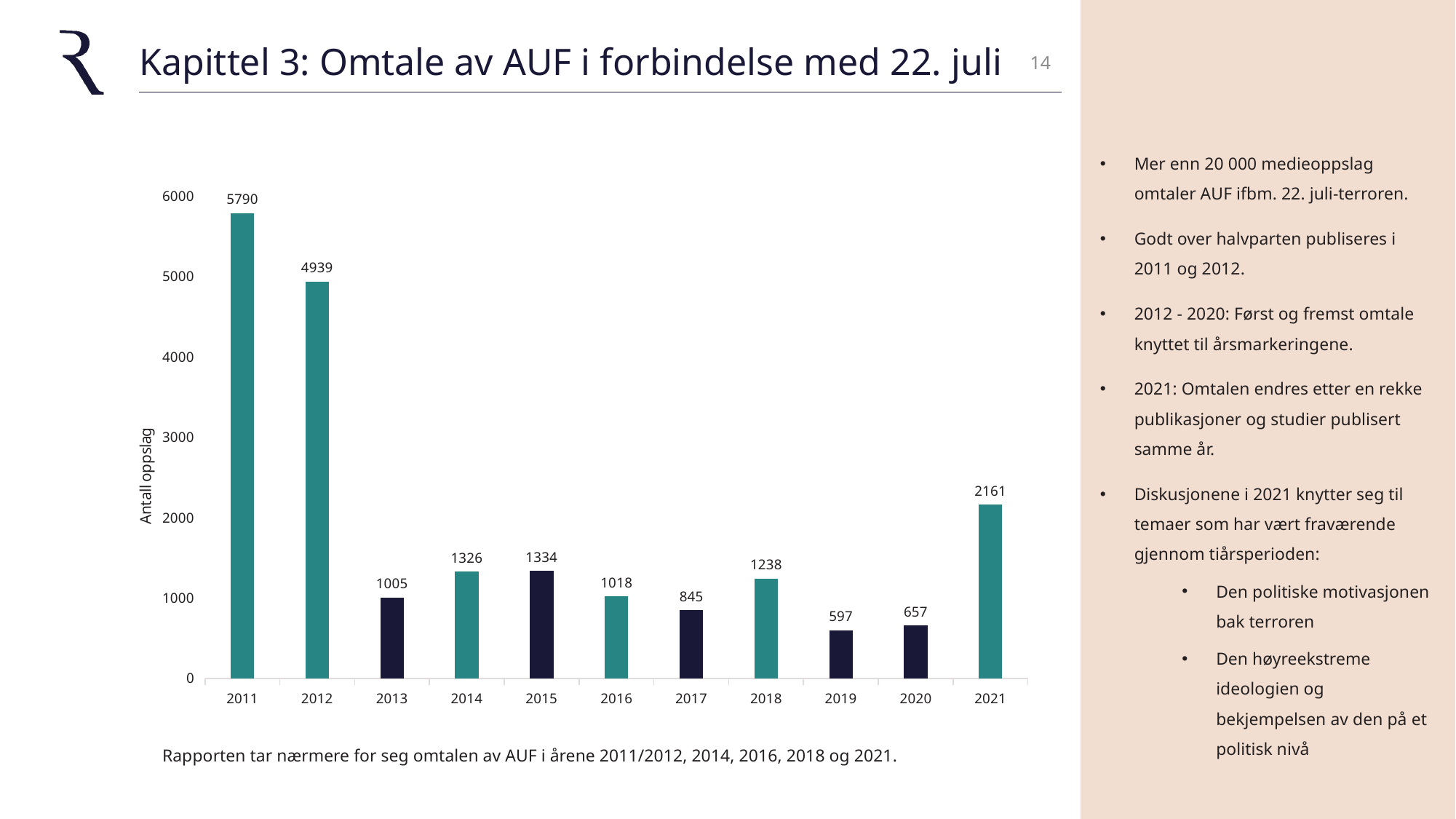
What is the label of the y axis? Antall oppslag How many years are shown on the x axis? 11 What is the value for 2019? 597 Which year has the lowest value? 2019 Which is larger, the value for 2014 or the value for 2016? 2014 What is the value for 2021? 2161 What is the difference between the values for 2021 and 2020? 1504 Which year has the highest value? 2011 What is the difference between the values for 2011 and 2012? 851 What kind of chart is shown? bar chart What is the value for 2011? 5790 Is the value for 2018 greater or less than 1000? greater